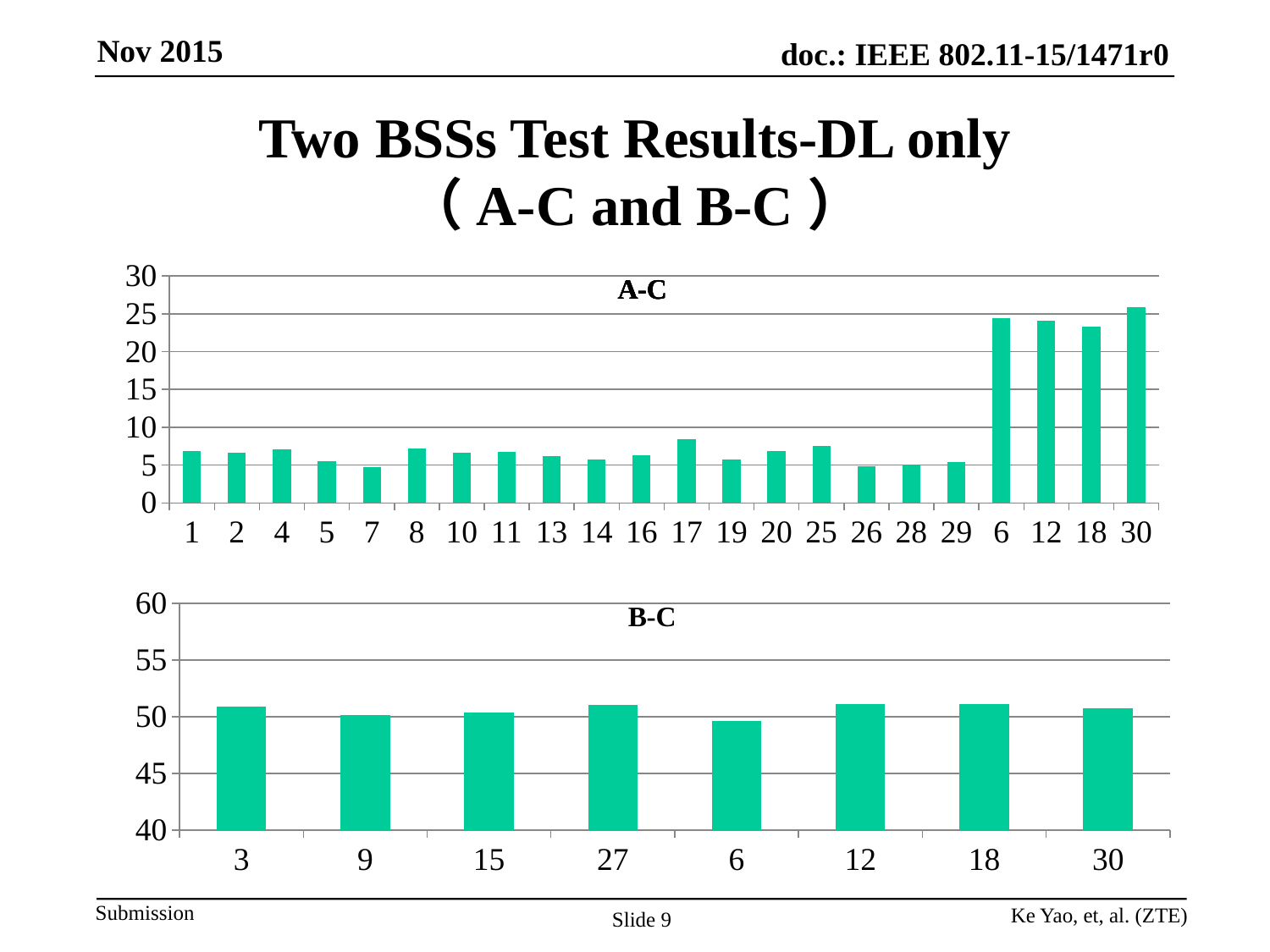
In the top chart (A-C), is the value for category 6 greater or less than 20? greater In the top chart (A-C), which is larger, the value for category 6 or the value for category 29? 6 In the top chart (A-C), is the value for category 25 greater or less than 10? less In the top chart (A-C), how many categories are shown on the x axis? 22 In the top chart (A-C), is the value for category 17 greater or less than 5? greater In the top chart (A-C), which category has the highest value? 30 What is the title of the bottom chart on the slide? B-C What kind of chart is the top chart titled A-C? bar chart In the bottom chart (B-C), which is larger, the value for category 27 or the value for category 6? 27 In the bottom chart (B-C), how many categories are shown on the x axis? 8 In the bottom chart (B-C), which category has the lowest value? 6